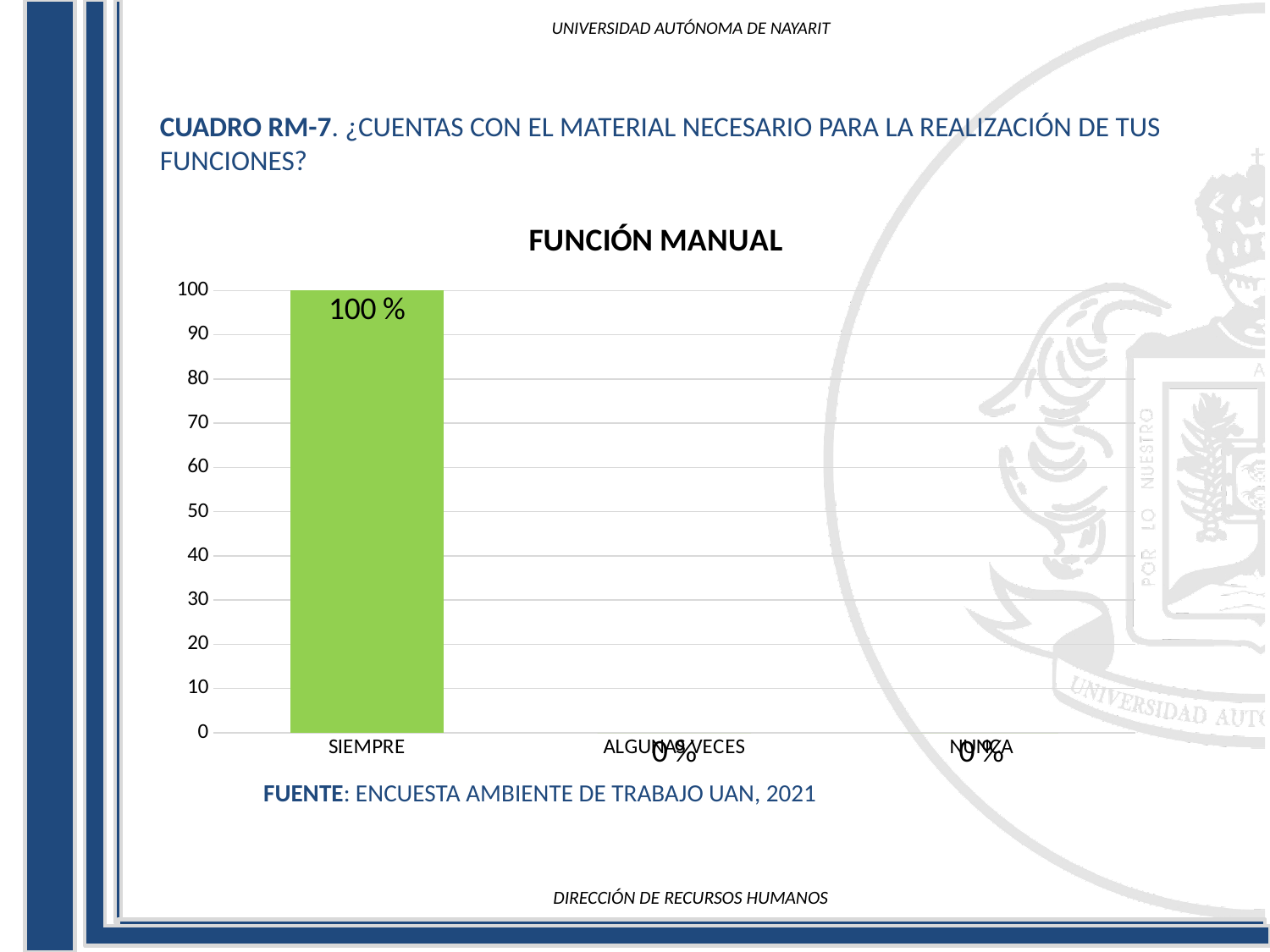
Which is larger in the FUNCIÓN MANUAL chart, the value for SIEMPRE or the value for ALGUNAS VECES? SIEMPRE What kind of chart is the FUNCIÓN MANUAL chart? bar chart What is the value for NUNCA in the FUNCIÓN MANUAL chart? 0 % Which category has the highest value in the FUNCIÓN MANUAL chart? SIEMPRE Do the values in the FUNCIÓN MANUAL chart rise or fall from SIEMPRE to NUNCA along the x axis? fall What is the value for ALGUNAS VECES in the FUNCIÓN MANUAL chart? 0 % What is the value for SIEMPRE in the FUNCIÓN MANUAL chart? 100 % What colour is the bar for SIEMPRE in the FUNCIÓN MANUAL chart? green How many categories are shown on the x axis of the FUNCIÓN MANUAL chart? 3 Is the value for SIEMPRE in the FUNCIÓN MANUAL chart greater or less than 50? greater What is the difference between the values for SIEMPRE and NUNCA in the FUNCIÓN MANUAL chart? 100 % What is the title of the chart on the slide? FUNCIÓN MANUAL